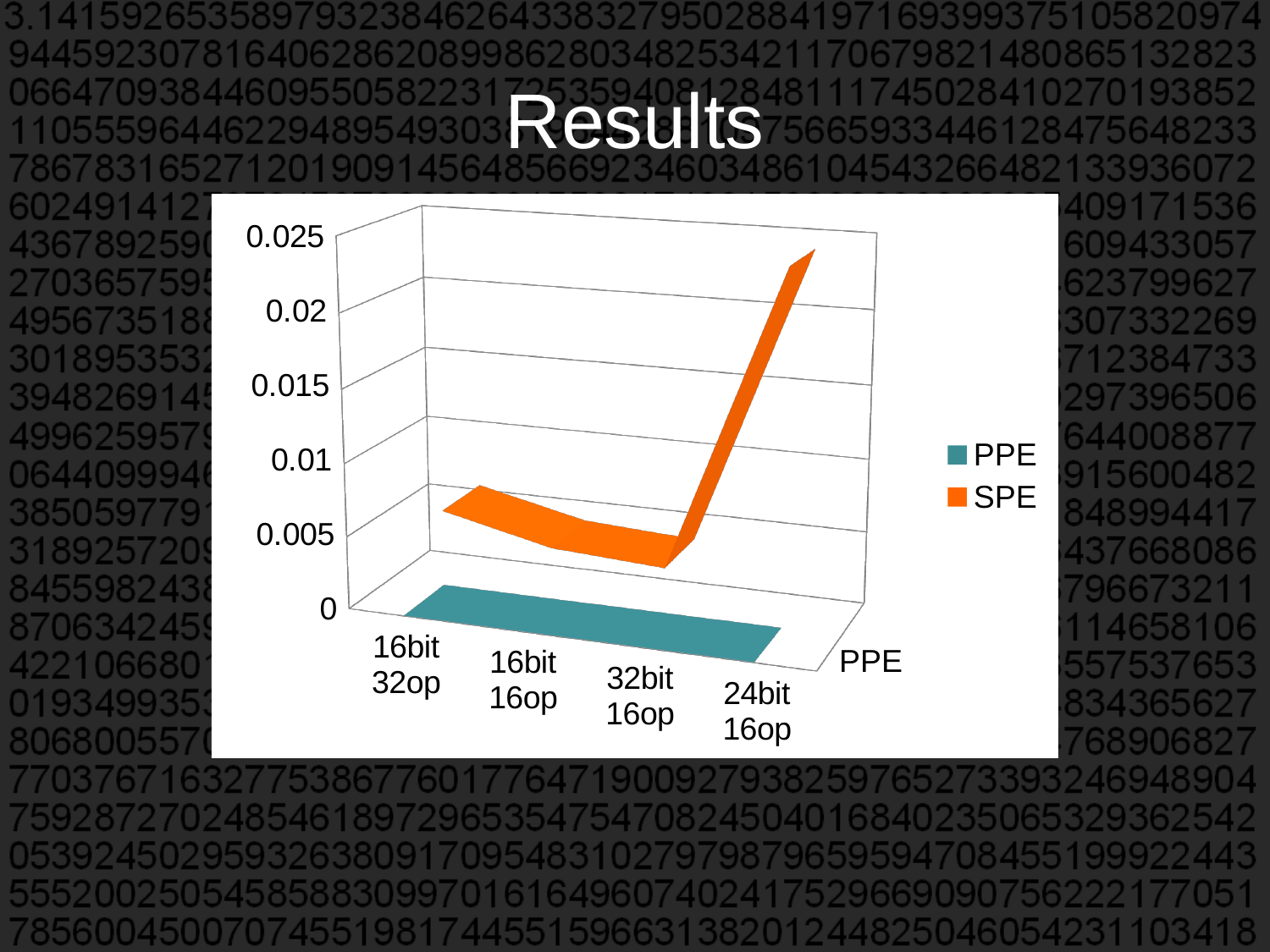
How many categories are shown on the x axis? 4 Is the PPE value for 16bit 32op greater or less than 0.005? less How many series does the legend list? 2 For which category is the SPE value lowest? 32bit 16op Is the SPE value for 32bit 16op greater or less than 0.01? less Which series has the larger value for 24bit 16op, PPE or SPE? SPE Which series are listed in the legend? PPE and SPE Does the SPE series rise or fall between 32bit 16op and 24bit 16op? rise For which category is the SPE value highest? 24bit 16op What is the title of the chart? Results Is the SPE value for 24bit 16op greater or less than 0.015? greater What kind of chart is shown on the slide? 3D line chart